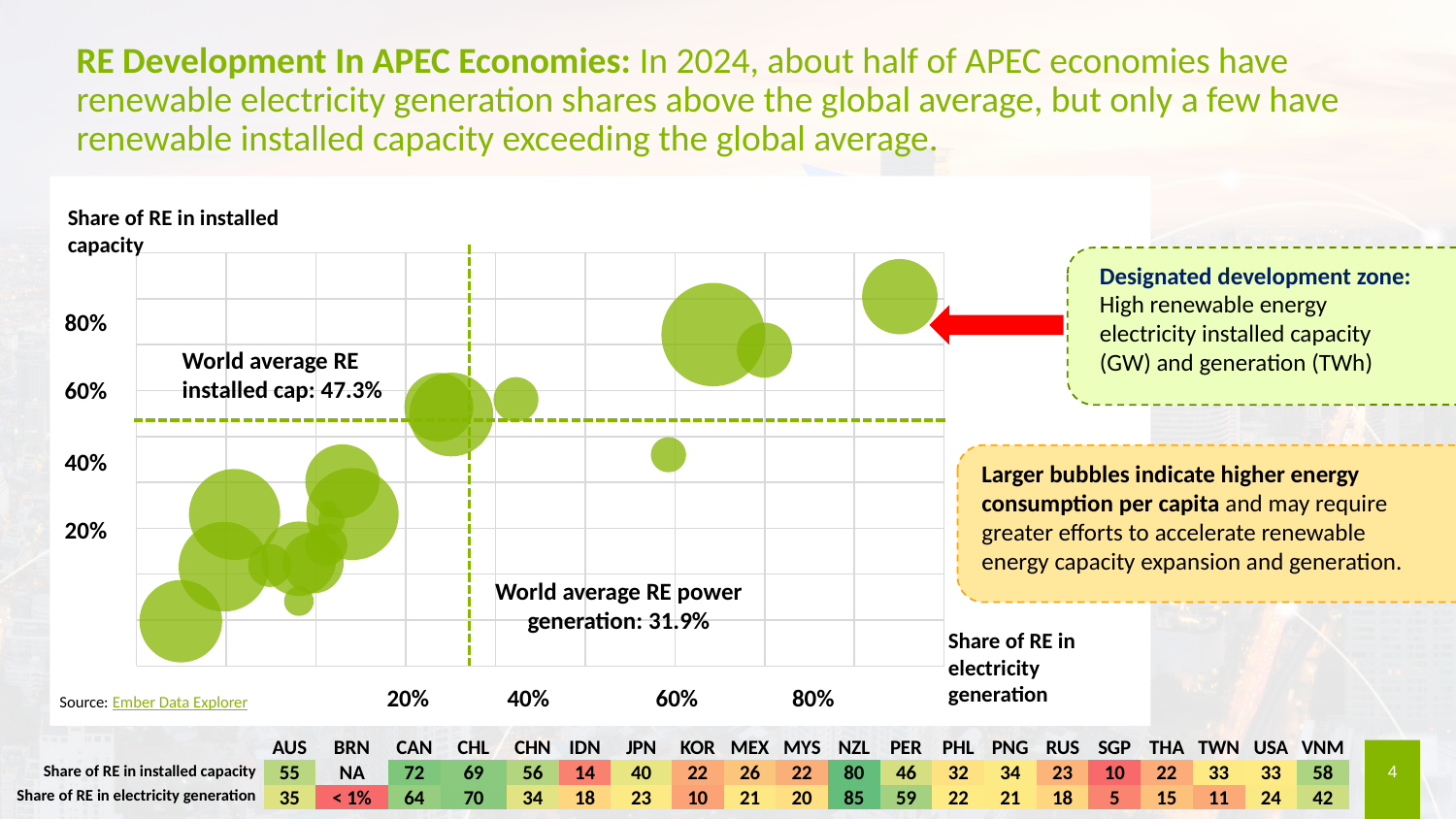
Which economy has the highest share of RE in installed capacity in the table? NZL What is the world average RE power generation share marked by the vertical dashed line? 31.9% What is the difference between CAN's and AUS's share of RE in installed capacity? 17 Which economy has the highest share of RE in electricity generation in the table? NZL Which has a higher share of RE in electricity generation, PER or PHL? PER Which economy has the lowest numeric share of RE in installed capacity in the table? SGP What kind of chart is shown on the slide? bubble chart According to the table, what is the share of RE in electricity generation for CHL? 70 How many economies are listed in the table below the chart? 20 According to the table, what is the share of RE in electricity generation for BRN? < 1% According to the table, what is the share of RE in installed capacity for AUS? 55 What is the world average RE installed capacity share marked by the horizontal dashed line? 47.3%